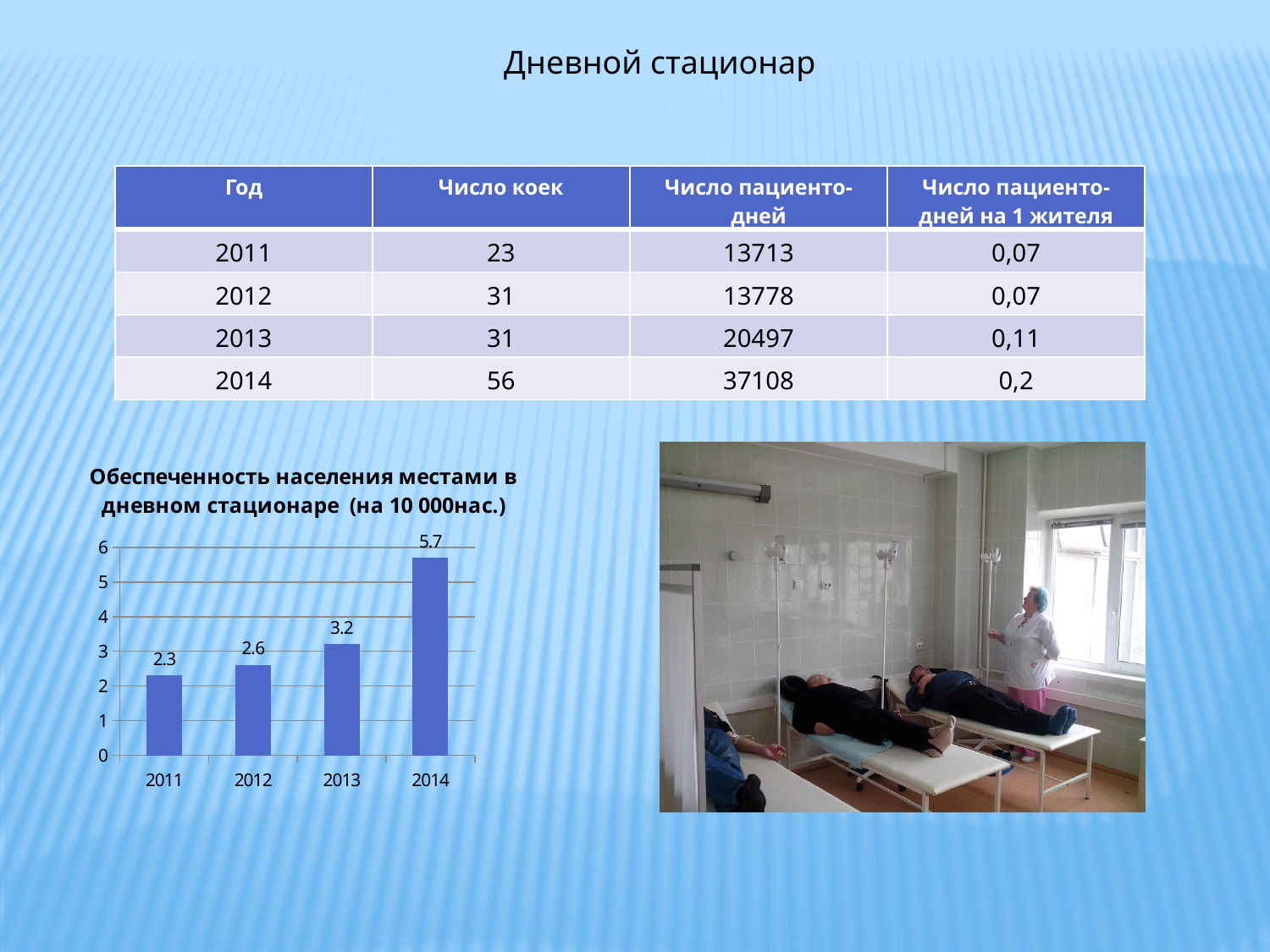
What is the difference between the values for 2012 and 2011 in the chart? 0.3 Which year has the lowest value in the chart? 2011 What is the value for 2014 in the chart? 5.7 What is the difference between the values for 2014 and 2013 in the chart? 2.5 What kind of chart is shown on the slide? bar chart How many years are shown in the chart? 4 Do the values in the chart rise or fall from 2011 to 2014? rise Which is larger in the chart, the value for 2012 or the value for 2013? 2013 What is the value for 2011 in the chart? 2.3 Is the value for 2014 in the chart greater or less than 5? greater What is the value for 2013 in the chart? 3.2 Which year has the highest value in the chart? 2014